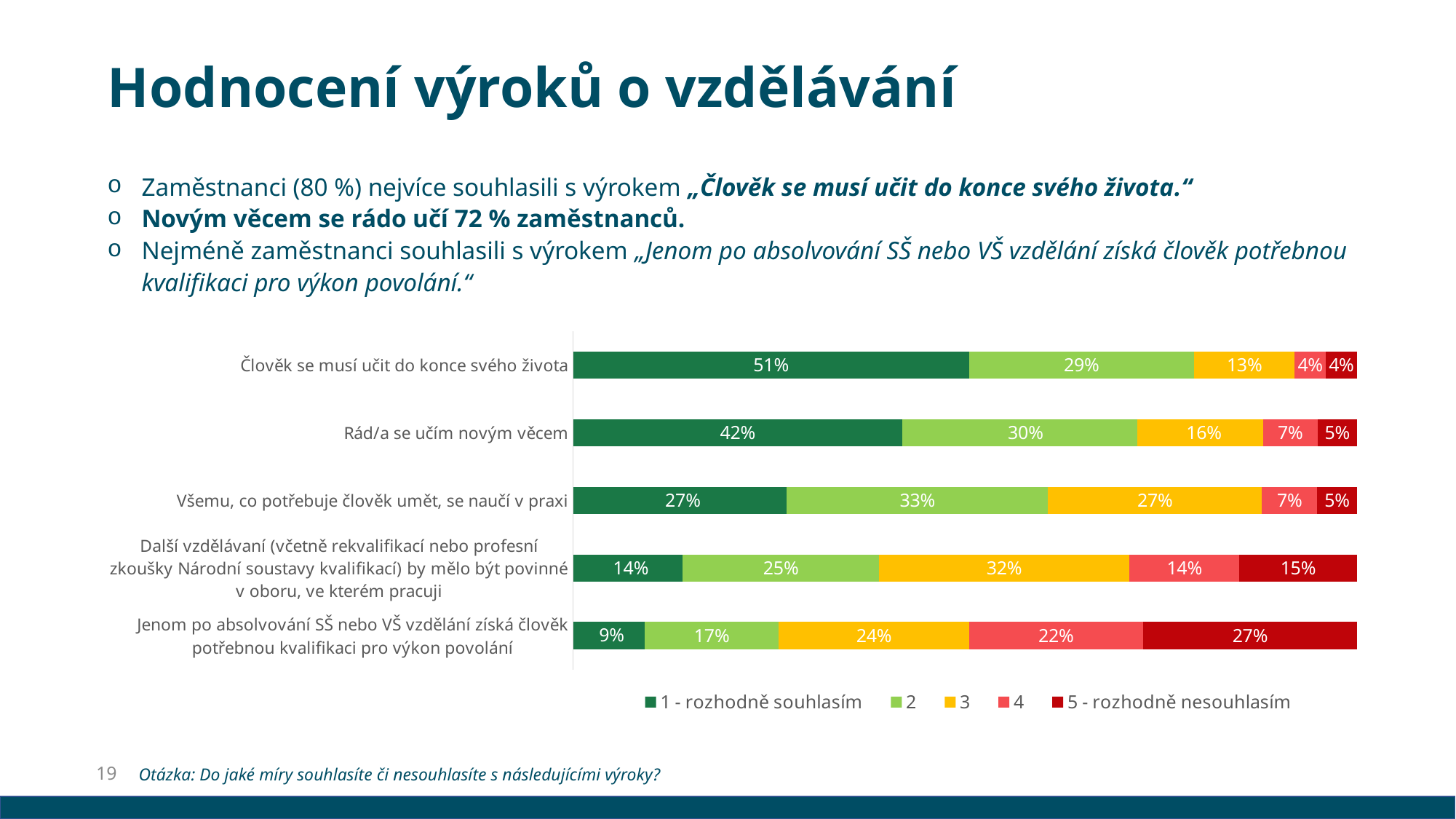
What is the difference in the "1 - rozhodně souhlasím" share between "Člověk se musí učit do konce svého života" and "Rád/a se učím novým věcem"? 9 percentage points What is the value of "5 - rozhodně nesouhlasím" for the statement "Jenom po absolvování SŠ nebo VŠ vzdělání získá člověk potřebnou kvalifikaci pro výkon povolání"? 27% What is the difference in the "5 - rozhodně nesouhlasím" share between "Jenom po absolvování SŠ nebo VŠ vzdělání získá člověk potřebnou kvalifikaci pro výkon povolání" and "Člověk se musí učit do konce svého života"? 23 percentage points What is the legend label of the dark green series in the chart? 1 - rozhodně souhlasím Which statement has a larger value for series "2": "Všemu, co potřebuje člověk umět, se naučí v praxi" or "Rád/a se učím novým věcem"? Všemu, co potřebuje člověk umět, se naučí v praxi Which statement has the highest share of "1 - rozhodně souhlasím"? Člověk se musí učit do konce svého života How many statements (categories) are shown in the chart? 5 What is the value of series "3" for the statement "Další vzdělávaní (včetně rekvalifikací nebo profesní zkoušky Národní soustavy kvalifikací) by mělo být povinné v oboru, ve kterém pracuji"? 32% What type of chart is shown on the slide? Stacked bar chart Which statement has the lowest share of "1 - rozhodně souhlasím"? Jenom po absolvování SŠ nebo VŠ vzdělání získá člověk potřebnou kvalifikaci pro výkon povolání How many series does the chart legend list? 5 What percentage of respondents chose "1 - rozhodně souhlasím" for the statement "Člověk se musí učit do konce svého života"? 51%